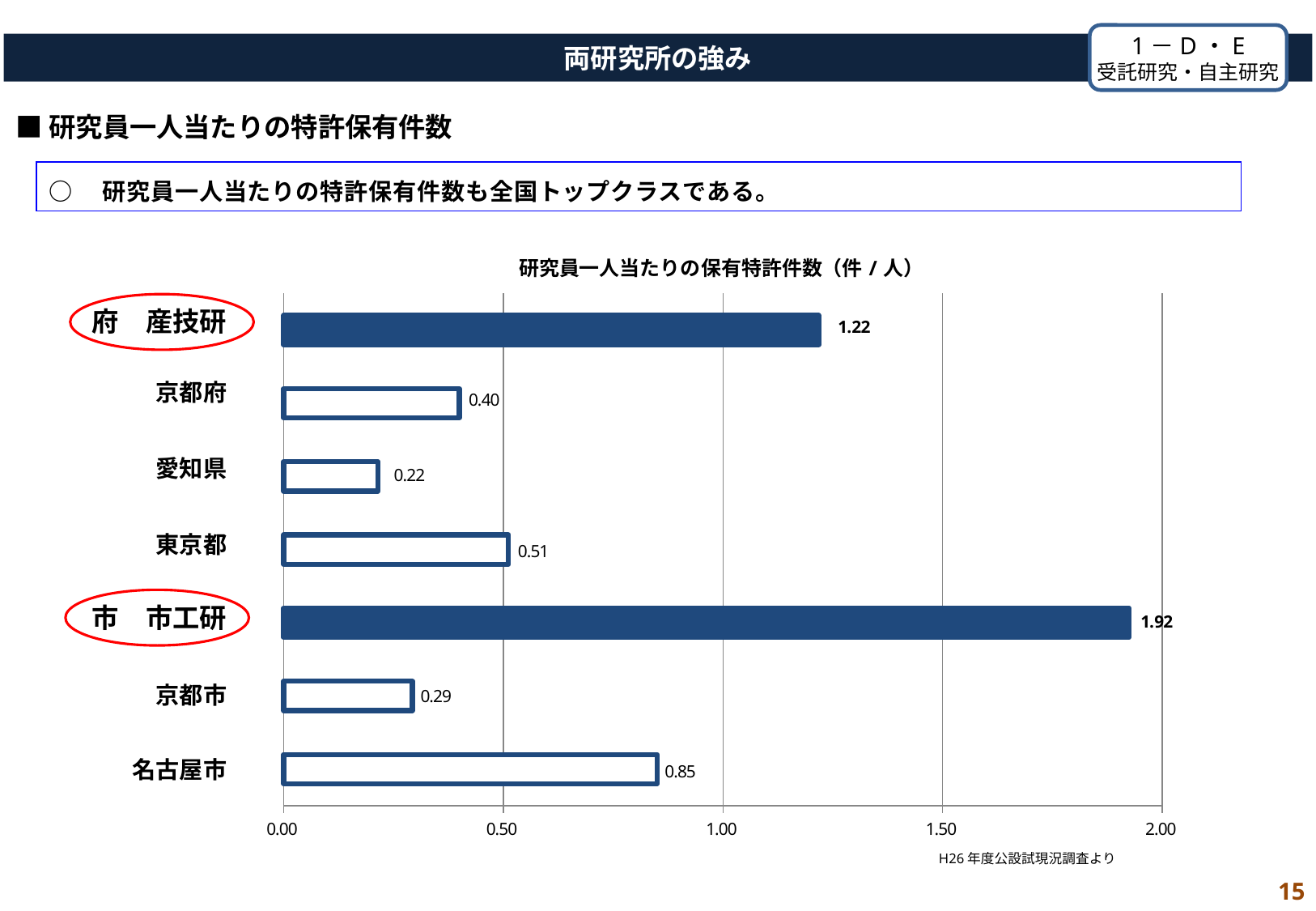
What is the value for 名古屋市? 0.85 What is the value for 府 産技研? 1.22 What is the difference between the values for 市 市工研 and 府 産技研? 0.70 What is the value for 愛知県? 0.22 Which category has the lowest value? 愛知県 What kind of chart is shown on the slide? bar chart Which category has the highest value? 市 市工研 What is the value for 市 市工研? 1.92 Is the value for 名古屋市 greater or less than 1.00? less What is the title of the chart? 研究員一人当たりの保有特許件数（件 / 人） Which is larger, the value for 東京都 or the value for 京都府? 東京都 How many categories are shown in the chart? 7